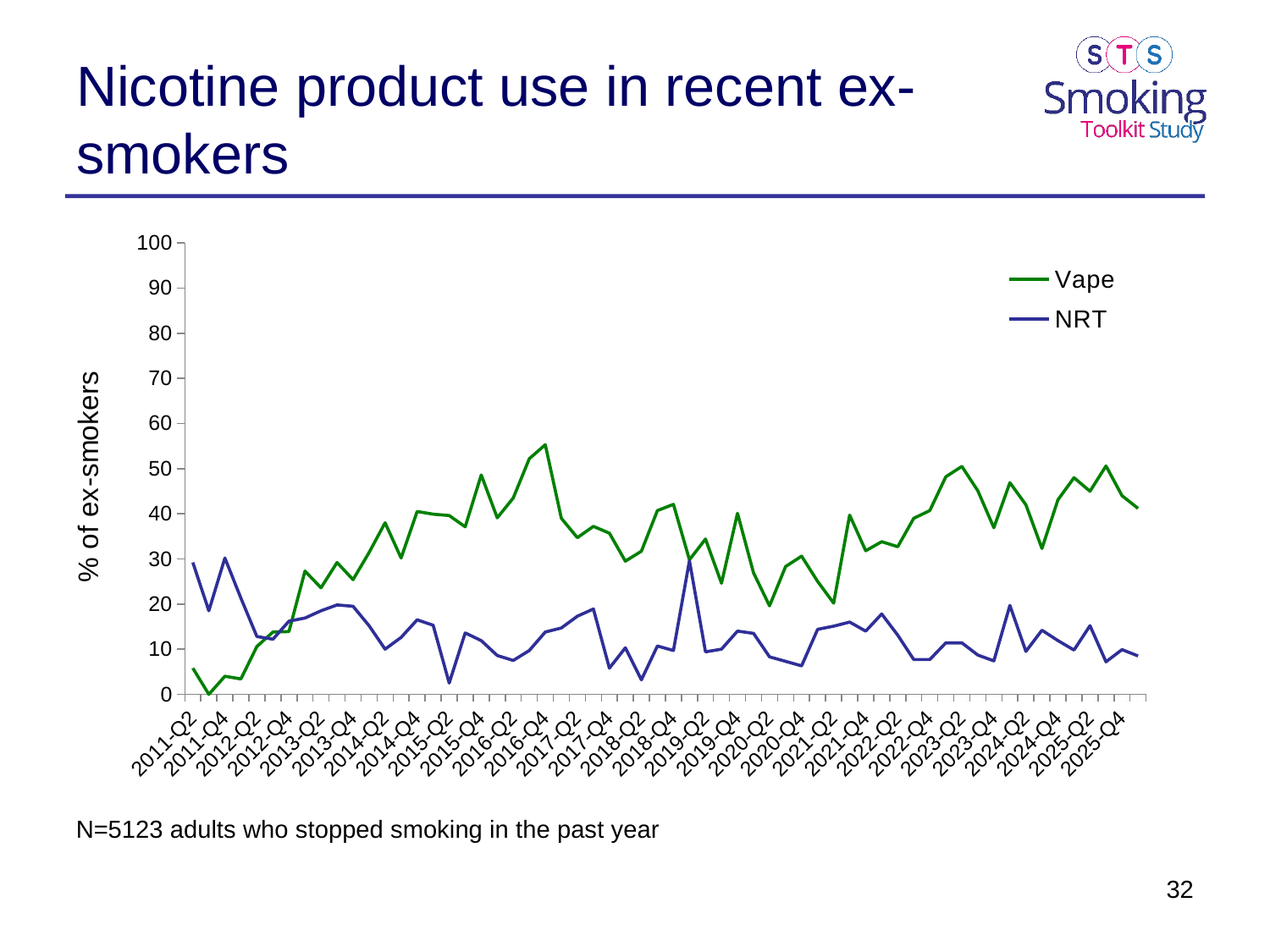
At 2025-Q4, which series has the higher value, Vape or NRT? Vape What kind of chart is shown on the slide? Line chart Is the Vape value at 2016-Q4 greater or less than 50? greater Is the Vape value at 2011-Q2 greater or less than 10? less Which series reaches the highest value anywhere on the chart? Vape Does the Vape line generally rise or fall between 2011-Q2 and 2016-Q4? Rise At 2011-Q2, which series has the higher value, Vape or NRT? NRT What is the label on the y axis? % of ex-smokers Is the NRT value at 2018-Q2 greater or less than 10? less Which two series are listed in the legend? Vape and NRT How many series does the legend list? 2